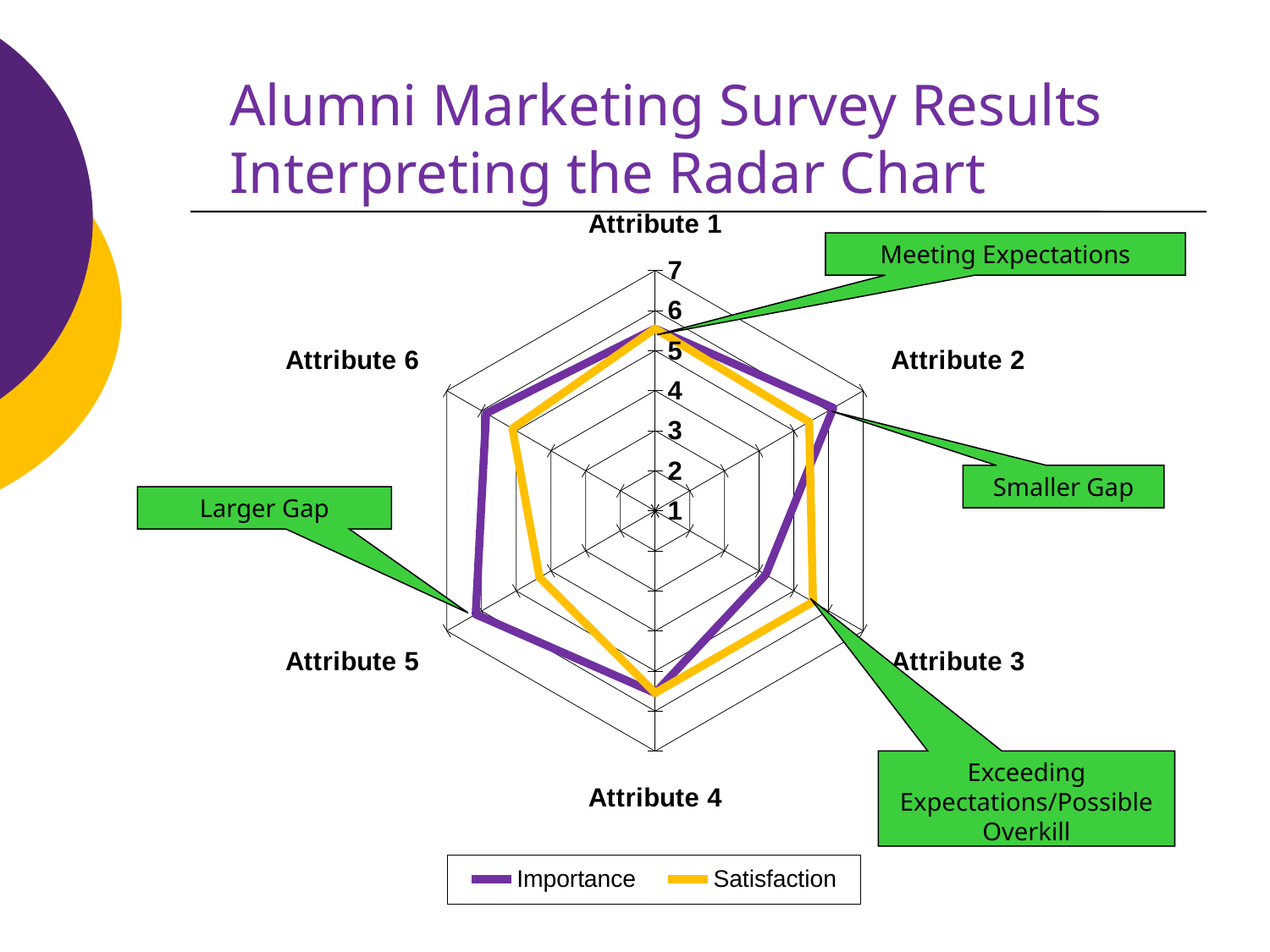
How many series does the legend list? 2 What is the highest value shown on the radar chart's axis scale? 7 Which series is drawn in purple? Importance Is the Importance value for Attribute 5 greater or less than 4? greater What kind of chart is shown on the slide? Radar chart Is the Importance value for Attribute 3 greater or less than 6? less Is the Satisfaction value for Attribute 5 greater or less than 6? less For Attribute 2, which series has the larger value, Importance or Satisfaction? Importance For Attribute 5, which series has the larger value, Importance or Satisfaction? Importance How many attributes (categories) are plotted on the radar chart? 6 For Attribute 3, which series has the larger value, Importance or Satisfaction? Satisfaction